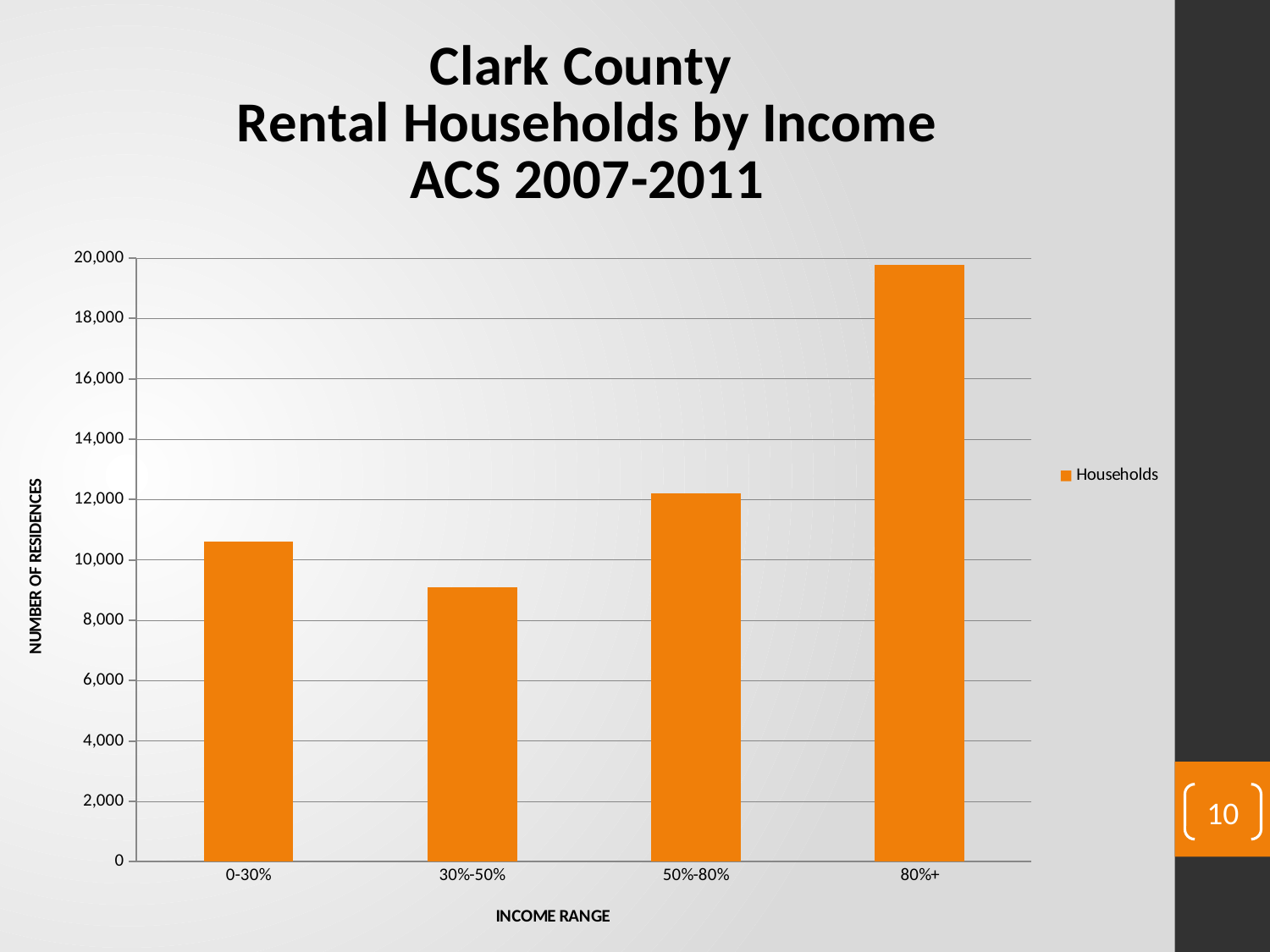
How many series does the legend list? 1 Is the value for 80%+ greater or less than 18,000? greater Which income range has the lowest number of rental households? 30%-50% Is the value for 30%-50% greater or less than 10,000? less Is the value for 0-30% greater or less than 10,000? greater What type of chart is shown on the slide? bar chart What series name appears in the legend? Households How many income range categories are shown on the x axis? 4 Which has more rental households, the 0-30% range or the 50%-80% range? 50%-80% Which income range has the highest number of rental households? 80%+ What is the label of the y axis? NUMBER OF RESIDENCES